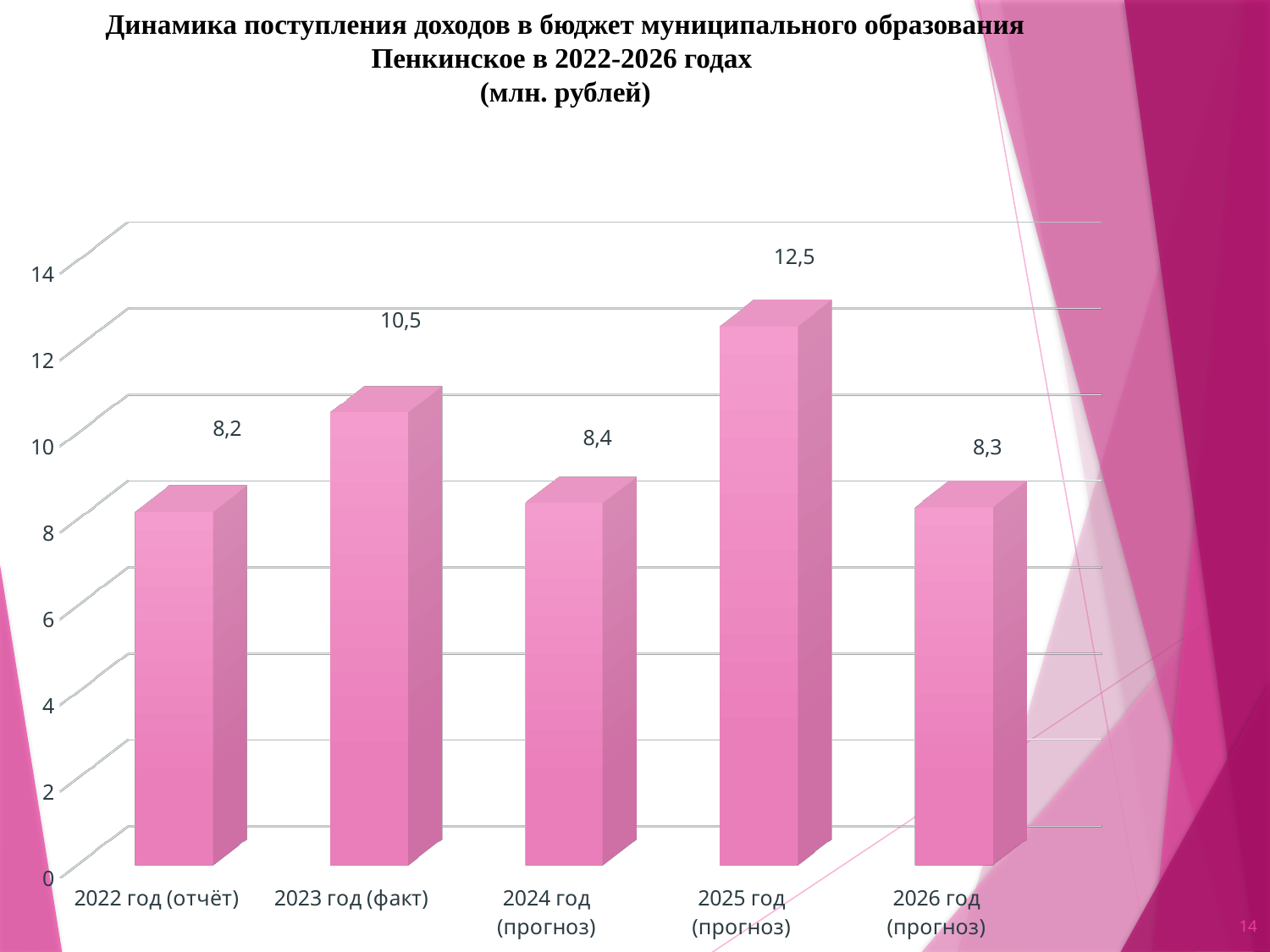
What is the value for 2022 год (отчёт)? 8,2 Which year has the lowest value? 2022 год (отчёт) Is the value for 2024 год (прогноз) greater or less than 10? less What is the value for 2025 год (прогноз)? 12,5 What is the difference between the values for 2025 год (прогноз) and 2024 год (прогноз)? 4,1 In what units are the values on the chart given, according to the title? млн. рублей What is the value for 2026 год (прогноз)? 8,3 How many years are shown on the chart? 5 Which is larger, the value for 2023 год (факт) or the value for 2026 год (прогноз)? 2023 год (факт) What kind of chart is shown on the slide? bar chart Which year has the highest value? 2025 год (прогноз) What is the value for 2023 год (факт)? 10,5